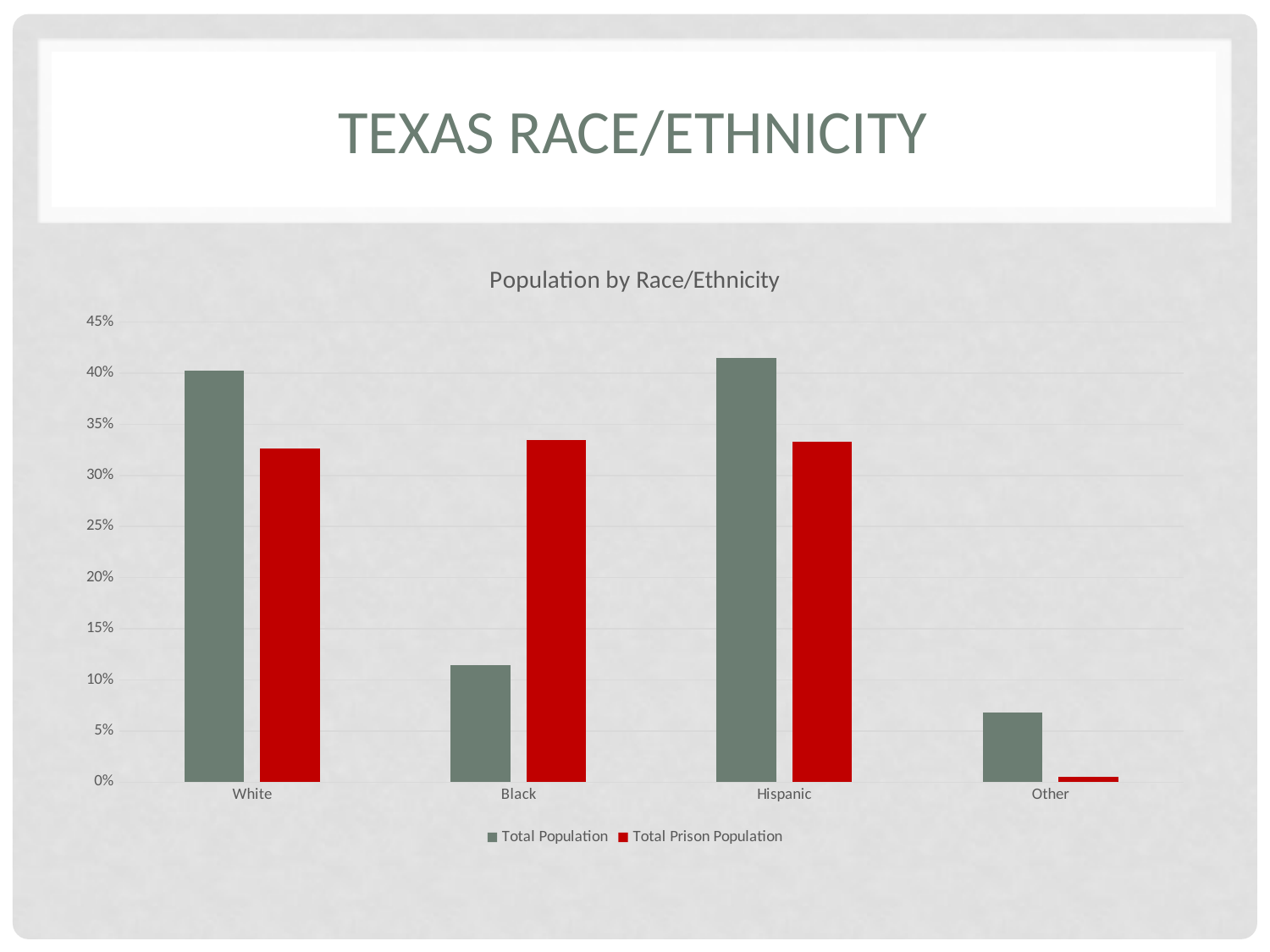
Which category has the lowest Total Population value? Other For White, which is larger: Total Population or Total Prison Population? Total Population Is the Total Population value for White greater or less than 35%? greater What is the title of the chart? Population by Race/Ethnicity For Black, which is larger: Total Population or Total Prison Population? Total Prison Population Which colour represents the Total Prison Population series? red How many series does the legend list? 2 Is the Total Prison Population value for Other greater or less than 5%? less What kind of chart is shown on the slide? bar chart Is the Total Population value for Black greater or less than 10%? greater How many race/ethnicity categories are shown on the x axis? 4 Which category has the lowest Total Prison Population value? Other